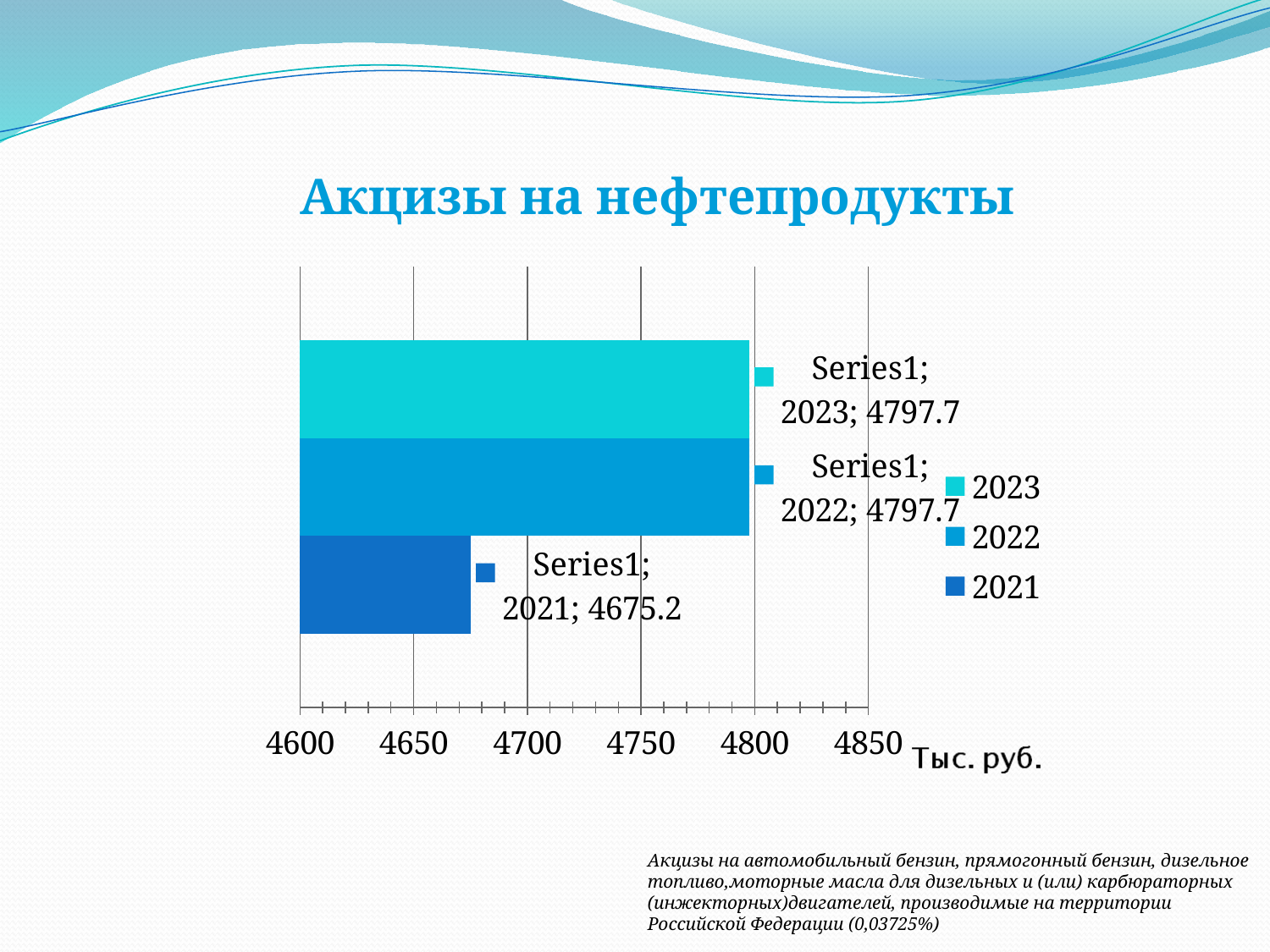
Which is larger, the value for 2021 or the value for 2023? 2023 What is the value for 2022 in the chart? 4797.7 What kind of chart is shown on the slide? bar chart What is the title of the chart? Акцизы на нефтепродукты What is the value for 2023 in the chart? 4797.7 Is the value for 2021 greater or less than 4700? less Is the value for 2023 greater or less than 4750? greater What is the value for 2021 in the chart? 4675.2 How many entries does the legend list? 3 Which year has the lowest value in the chart? 2021 What is the difference between the values for 2022 and 2021? 122.5 How many bars are plotted in the chart? 3